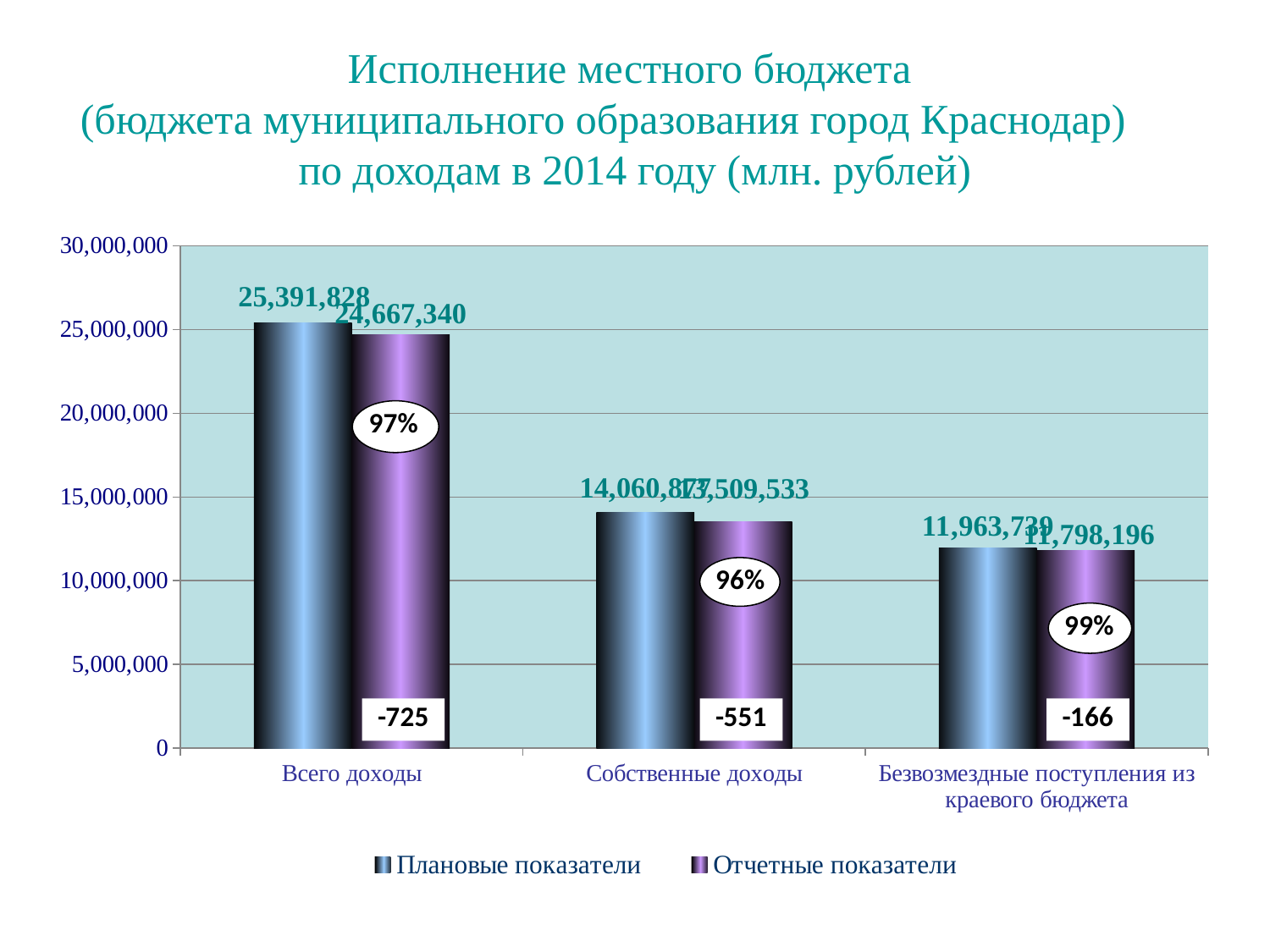
What is the difference between Плановые показатели and Отчетные показатели for Всего доходы? 724,488 How many categories are shown on the x axis? 3 Is the value of Плановые показатели for Собственные доходы greater or less than 15,000,000? less What is the value of Плановые показатели for Всего доходы? 25,391,828 What type of chart is shown on the slide? bar chart What execution percentage is shown for Безвозмездные поступления из краевого бюджета? 99% How many series does the legend list? 2 Which category has the lowest value for Плановые показатели? Безвозмездные поступления из краевого бюджета What is the value of Отчетные показатели for Собственные доходы? 13,509,533 Which category has the highest value for Отчетные показатели? Всего доходы What is the value of Отчетные показатели for Безвозмездные поступления из краевого бюджета? 11,798,196 What is the value of Отчетные показатели for Всего доходы? 24,667,340